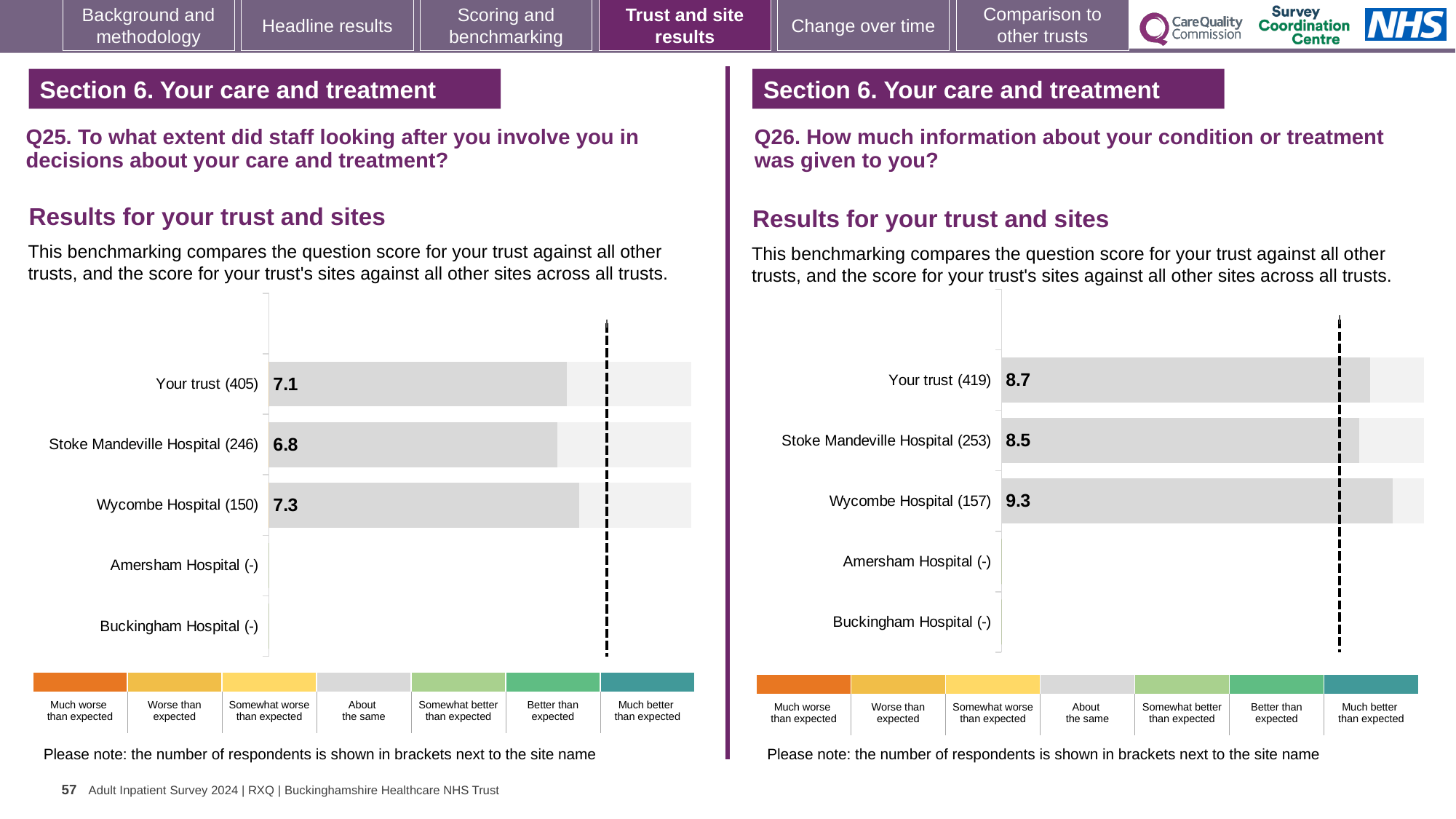
On the Q26 chart (right), which site or trust has the lowest score? Stoke Mandeville Hospital On the Q25 chart (left), what is the difference between the scores for Wycombe Hospital and Stoke Mandeville Hospital? 0.5 On the Q25 chart (left), what is the score for Your trust? 7.1 On the Q26 chart (right), what is the score for Your trust? 8.7 On the Q26 chart (right), what is the score for Wycombe Hospital? 9.3 On the Q26 chart (right), is the score for Wycombe Hospital larger or smaller than the score for Your trust? larger On the Q26 chart (right), how many sites or trusts have a score bar plotted? 3 On the Q25 chart (left), what is the score for Stoke Mandeville Hospital? 6.8 What kind of chart is used on the Q25 chart (left)? Bar chart On the Q25 chart (left), how many respondents are shown for Your trust? 405 On the Q25 chart (left), which site or trust has the highest score? Wycombe Hospital On the Q26 chart (right), what is the difference between the scores for Wycombe Hospital and Your trust? 0.6